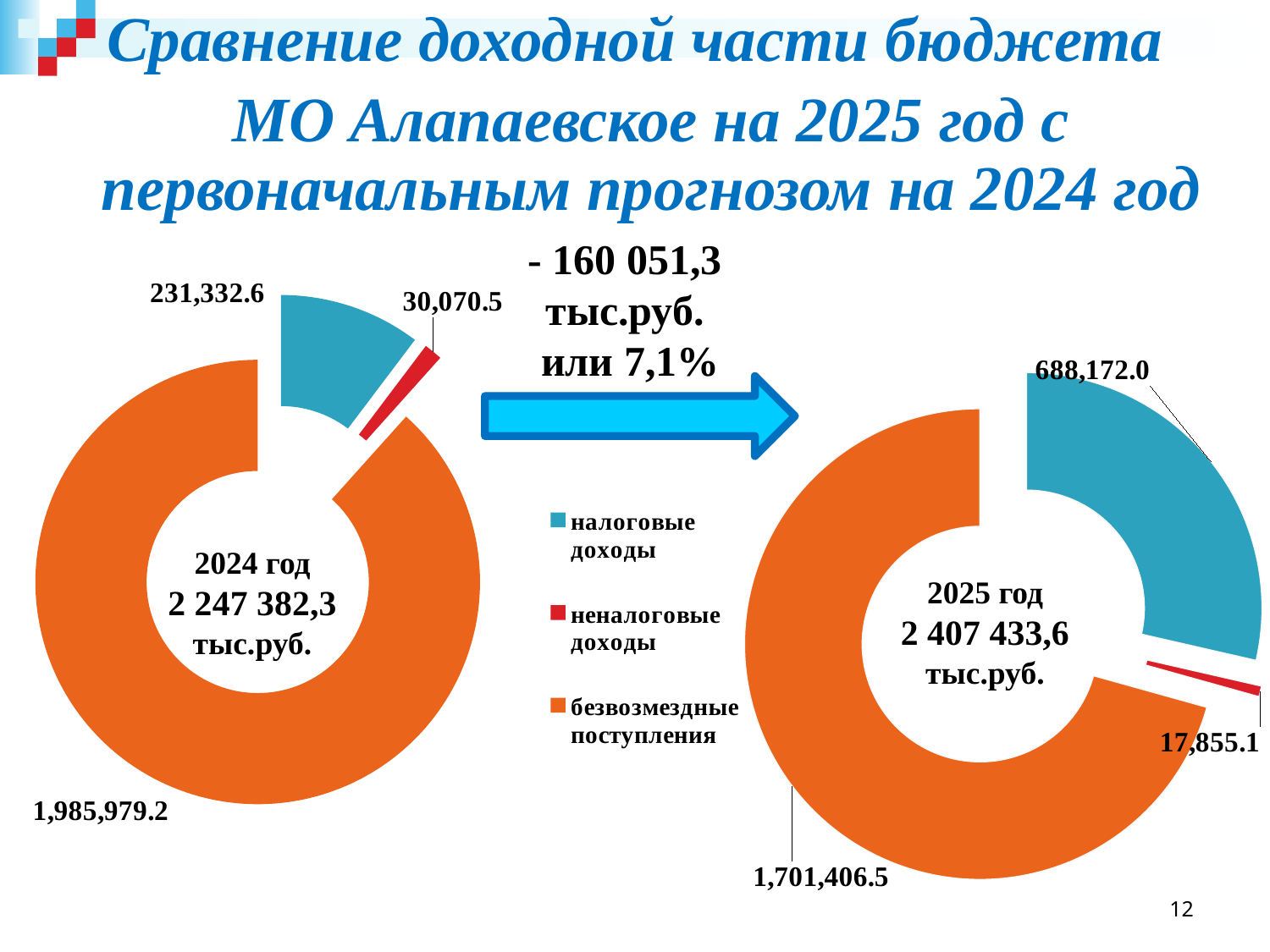
On the right chart (2025 год), what is the value for неналоговые доходы? 17,855.1 What is the difference between налоговые доходы on the right chart (2025 год) and on the left chart (2024 год)? 456,839.4 How many series does the legend list? 3 On the right chart (2025 год), which category has the smallest value? неналоговые доходы What kind of chart is the right chart (2025 год)? doughnut chart On the left chart (2024 год), which category has the largest value? безвозмездные поступления What total is printed in the centre of the left chart (2024 год)? 2 247 382,3 тыс.руб. How many categories does the left chart (2024 год) show? 3 On the left chart (2024 год), what is the value for налоговые доходы? 231,332.6 What is the difference between безвозмездные поступления on the left chart (2024 год) and on the right chart (2025 год)? 284,572.7 Which is larger: неналоговые доходы on the left chart (2024 год) or on the right chart (2025 год)? 2024 год (30,070.5) On the right chart (2025 год), what is the value for безвозмездные поступления? 1,701,406.5